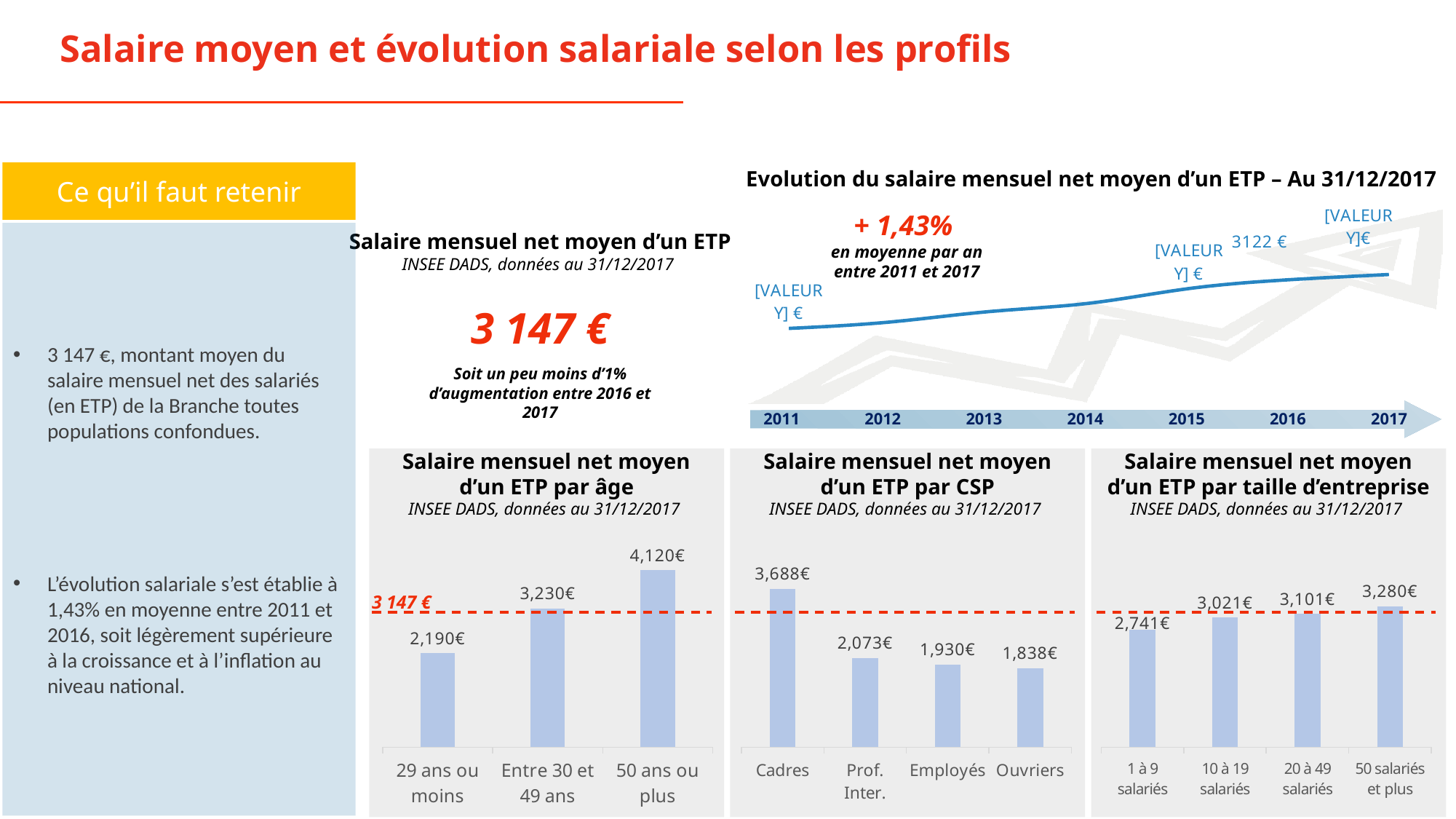
In the chart 'Salaire mensuel net moyen d'un ETP par CSP', what is the value for 'Cadres'? 3,688€ In the chart 'Salaire mensuel net moyen d'un ETP par âge', which age group has the lowest value? 29 ans ou moins In the chart 'Evolution du salaire mensuel net moyen d'un ETP – Au 31/12/2017', do the values rise or fall from 2011 to 2017? Rise In the chart 'Salaire mensuel net moyen d'un ETP par taille d'entreprise', what is the value for '1 à 9 salariés'? 2,741€ In the chart 'Salaire mensuel net moyen d'un ETP par CSP', what is the difference between 'Prof. Inter.' and 'Employés'? 143€ In the chart 'Salaire mensuel net moyen d'un ETP par taille d'entreprise', which category has the highest value? 50 salariés et plus In the chart 'Salaire mensuel net moyen d'un ETP par CSP', which category has the lowest value? Ouvriers What kind of chart is 'Evolution du salaire mensuel net moyen d'un ETP – Au 31/12/2017'? Line chart In the chart 'Salaire mensuel net moyen d'un ETP par âge', what is the value for '50 ans ou plus'? 4,120€ In the chart 'Salaire mensuel net moyen d'un ETP par CSP', how many categories are shown? 4 In the chart 'Salaire mensuel net moyen d'un ETP par taille d'entreprise', which is larger: '10 à 19 salariés' or '20 à 49 salariés'? 20 à 49 salariés In the chart 'Salaire mensuel net moyen d'un ETP par âge', what is the difference between '50 ans ou plus' and '29 ans ou moins'? 1,930€